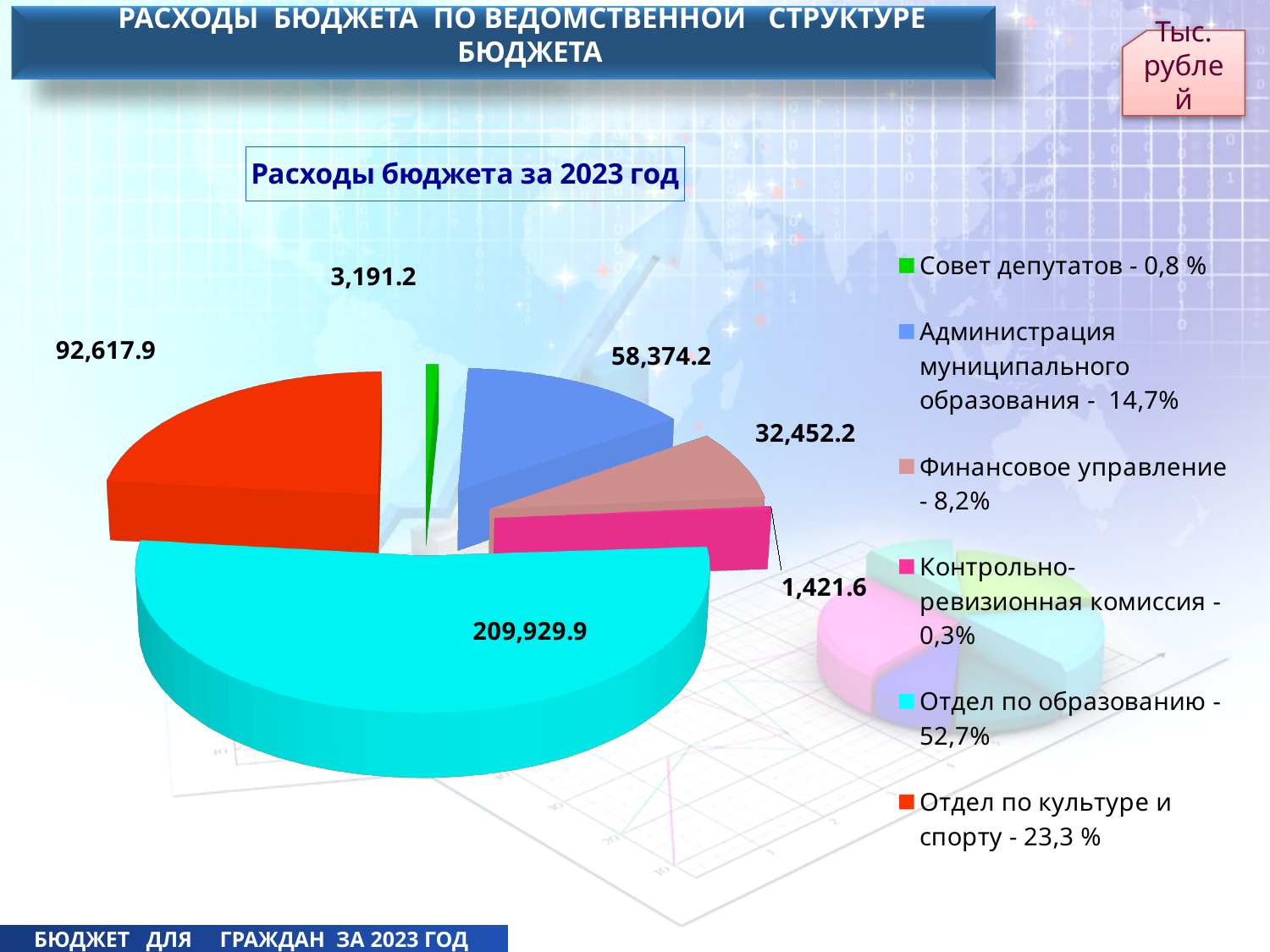
What is the difference between the values for Отдел по образованию and Отдел по культуре и спорту? 117,312.0 Which category has the smallest value? Контрольно-ревизионная комиссия What type of chart is shown on the slide? Pie chart Which is larger, the value for Финансовое управление or the value for Администрация муниципального образования? Администрация муниципального образования What is the value for Контрольно-ревизионная комиссия? 1,421.6 What share of the pie does Финансовое управление represent? 8,2% What is the value for Администрация муниципального образования? 58,374.2 What is the value for Отдел по образованию? 209,929.9 How many categories does the legend list? 6 What is the title of the chart? Расходы бюджета за 2023 год What share of the pie does Отдел по культуре и спорту represent? 23,3 % Which category has the largest value? Отдел по образованию